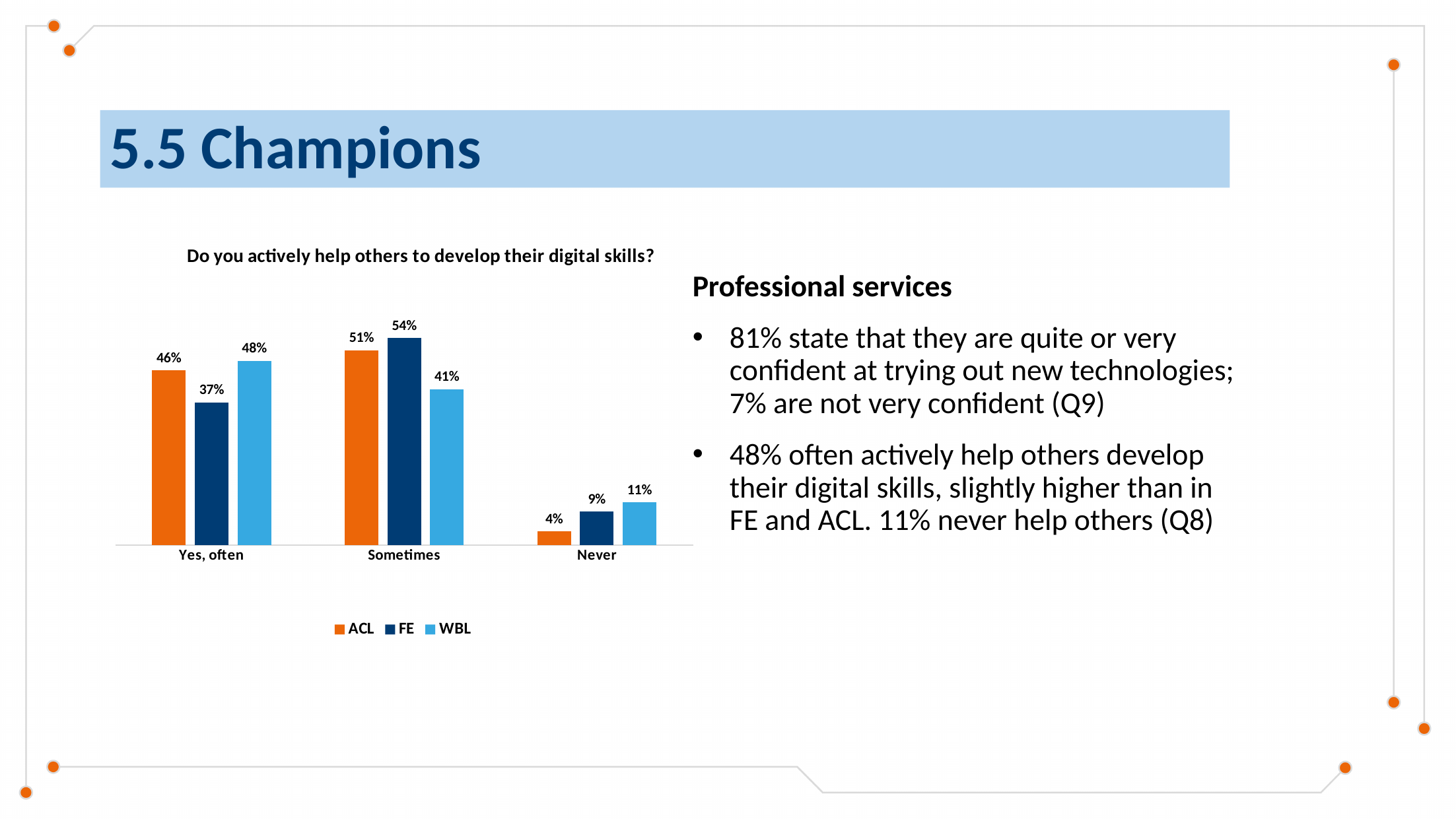
How many categories are shown on the x axis of the chart? 3 Which series has the lowest value in the 'Never' category? ACL Which series is shown in orange in the chart legend? ACL What is the value for ACL in the 'Yes, often' category? 46% What is the difference between the WBL and FE values in the 'Yes, often' category? 11% What is the value for FE in the 'Sometimes' category? 54% Which is larger: the ACL value for 'Sometimes' or the WBL value for 'Sometimes'? ACL What is the title of the chart? Do you actively help others to develop their digital skills? How many series does the legend list? 3 Which series has the highest value in the 'Sometimes' category? FE What is the value for WBL in the 'Never' category? 11% What kind of chart is shown on the slide? Bar chart